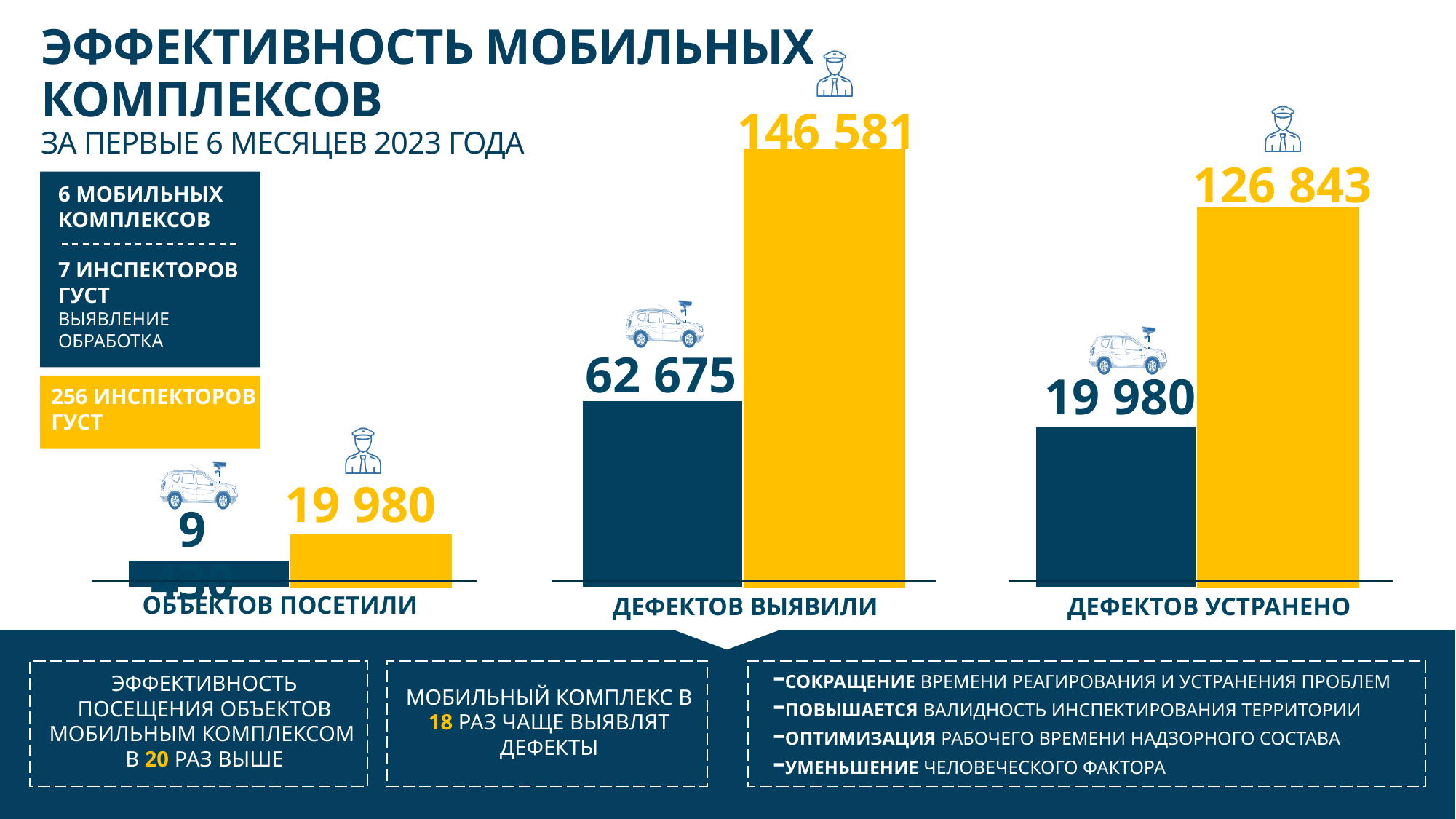
In the 'ОБЪЕКТОВ ПОСЕТИЛИ' chart, what is the value of the yellow bar? 19 980 In the 'ОБЪЕКТОВ ПОСЕТИЛИ' chart, which bar is taller, the dark blue one or the yellow one? the yellow one What does the yellow colour represent according to the legend on the slide? 256 инспекторов ГУСТ In the 'ДЕФЕКТОВ УСТРАНЕНО' chart, what is the difference between the yellow bar and the dark blue bar? 106 863 In the 'ДЕФЕКТОВ ВЫЯВИЛИ' chart, what is the value of the dark blue bar (мобильные комплексы)? 62 675 In the 'ДЕФЕКТОВ ВЫЯВИЛИ' chart, what is the difference between the yellow bar and the dark blue bar? 83 906 In the 'ДЕФЕКТОВ УСТРАНЕНО' chart, what is the value of the yellow bar? 126 843 What kind of chart is used on this slide? bar chart In the 'ДЕФЕКТОВ ВЫЯВИЛИ' chart, what is the value of the yellow bar (256 инспекторов ГУСТ)? 146 581 How many bar groups (categories) are shown on the slide? 3 In the 'ДЕФЕКТОВ ВЫЯВИЛИ' chart, which bar is taller, the dark blue one or the yellow one? the yellow one In the 'ДЕФЕКТОВ УСТРАНЕНО' chart, what is the value of the dark blue bar? 19 980